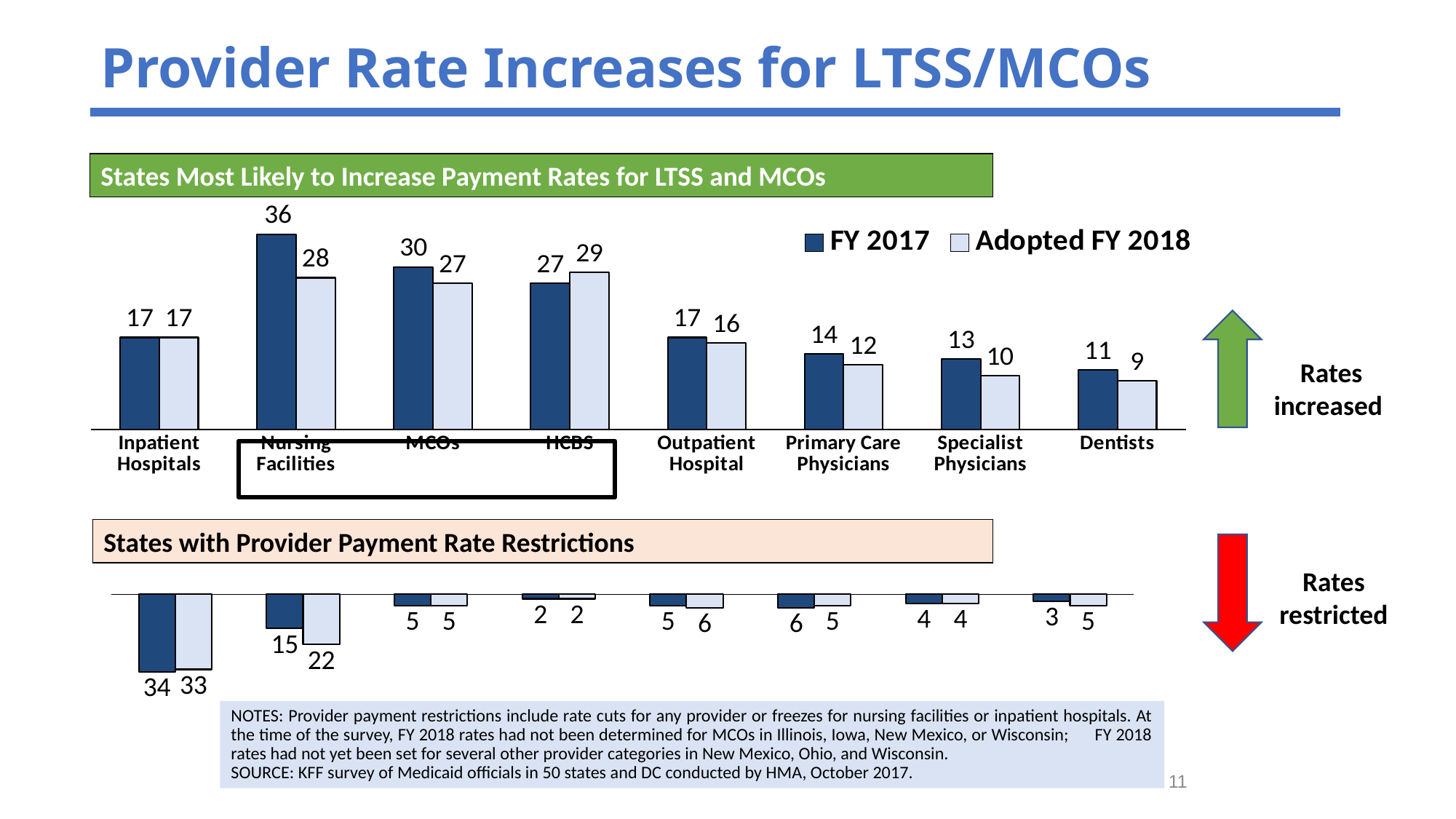
In the chart 'States Most Likely to Increase Payment Rates for LTSS and MCOs', which category has the lowest Adopted FY 2018 value? Dentists In the chart 'States Most Likely to Increase Payment Rates for LTSS and MCOs', what is the FY 2017 value for Nursing Facilities? 36 In the chart 'States Most Likely to Increase Payment Rates for LTSS and MCOs', which is larger for HCBS: the FY 2017 value or the Adopted FY 2018 value? Adopted FY 2018 In the chart 'States Most Likely to Increase Payment Rates for LTSS and MCOs', what is the difference between the FY 2017 and Adopted FY 2018 values for Nursing Facilities? 8 In the chart 'States Most Likely to Increase Payment Rates for LTSS and MCOs', which category has the highest FY 2017 value? Nursing Facilities What kind of chart is 'States Most Likely to Increase Payment Rates for LTSS and MCOs'? Bar chart How many categories are shown on the x axis of the chart 'States Most Likely to Increase Payment Rates for LTSS and MCOs'? 8 In the chart 'States with Provider Payment Rate Restrictions', what are the FY 2017 and Adopted FY 2018 values for the first (leftmost) bar pair? 34 and 33 In the chart 'States Most Likely to Increase Payment Rates for LTSS and MCOs', what is the Adopted FY 2018 value for HCBS? 29 In the chart 'States with Provider Payment Rate Restrictions', what is the difference between the Adopted FY 2018 and FY 2017 values for the second bar pair from the left? 7 How many series does the legend of the chart 'States Most Likely to Increase Payment Rates for LTSS and MCOs' list? 2 What are the two series named in the legend of the chart 'States Most Likely to Increase Payment Rates for LTSS and MCOs'? FY 2017 and Adopted FY 2018